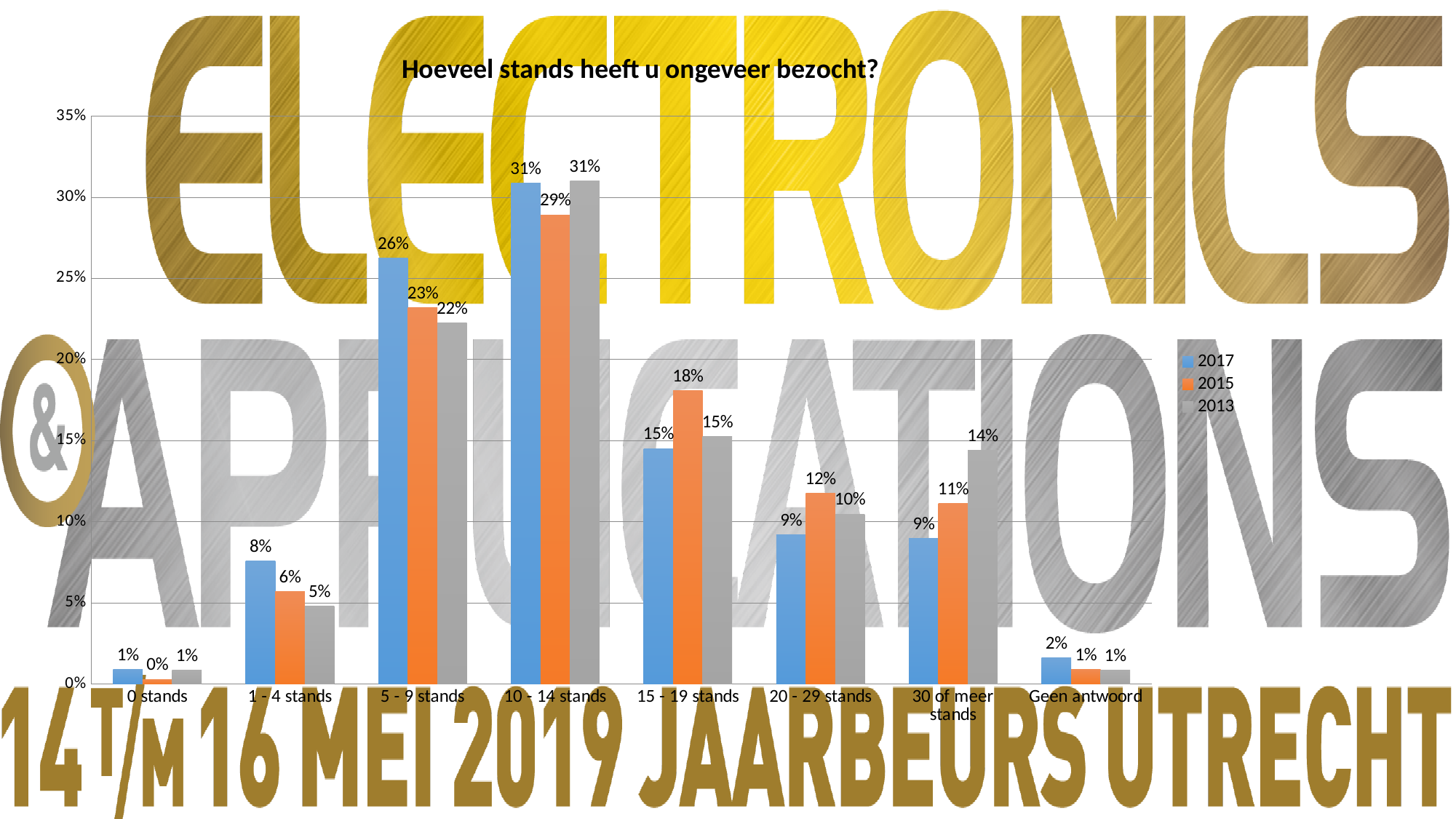
How many categories are shown on the x axis? 8 What is the 2017 value for 5 - 9 stands? 26% What is the 2015 value for 10 - 14 stands? 29% Which is larger for 20 - 29 stands: the 2015 value or the 2013 value? 2015 What is the difference between the 2017 and 2013 values for 5 - 9 stands? 4% What kind of chart is shown? bar chart Which category has the highest 2017 value? 10 - 14 stands What is the title of the chart? Hoeveel stands heeft u ongeveer bezocht? How many series does the legend list? 3 What is the 2015 value for 15 - 19 stands? 18% Which category has the lowest 2015 value? 0 stands What is the 2013 value for 30 of meer stands? 14%